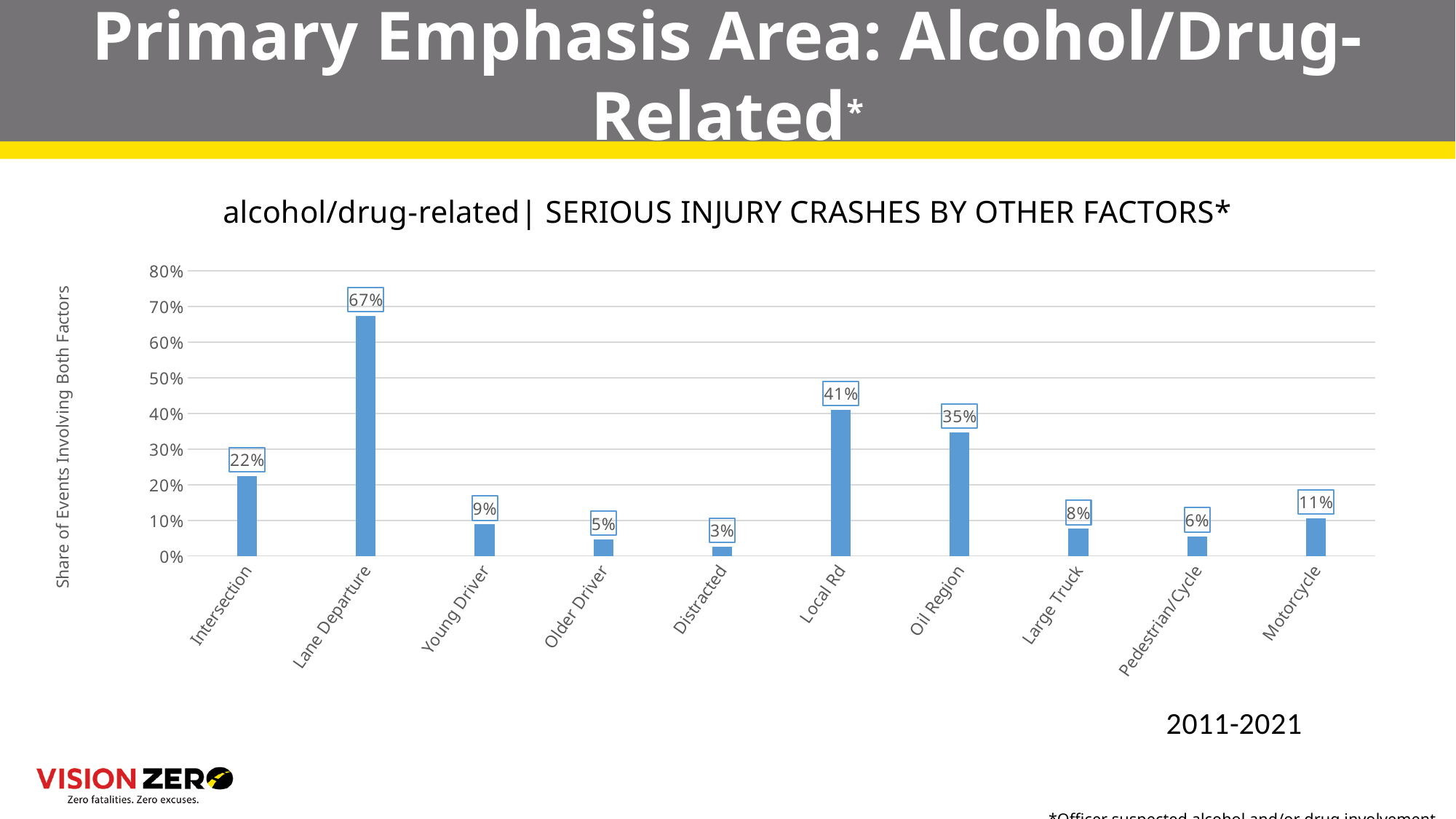
What is the label of the y axis? Share of Events Involving Both Factors What is the title of the chart? alcohol/drug-related| SERIOUS INJURY CRASHES BY OTHER FACTORS* What is the value for Lane Departure? 67% Which is larger, the value for Intersection or the value for Motorcycle? Intersection Which category has the highest value? Lane Departure What is the difference between the values for Local Rd and Oil Region? 6% Which category has the lowest value? Distracted What is the value for Local Rd? 41% How many categories are shown on the x axis? 10 What kind of chart is shown on the slide? Bar chart Is the value for Oil Region greater or less than 30%? greater What is the value for Pedestrian/Cycle? 6%